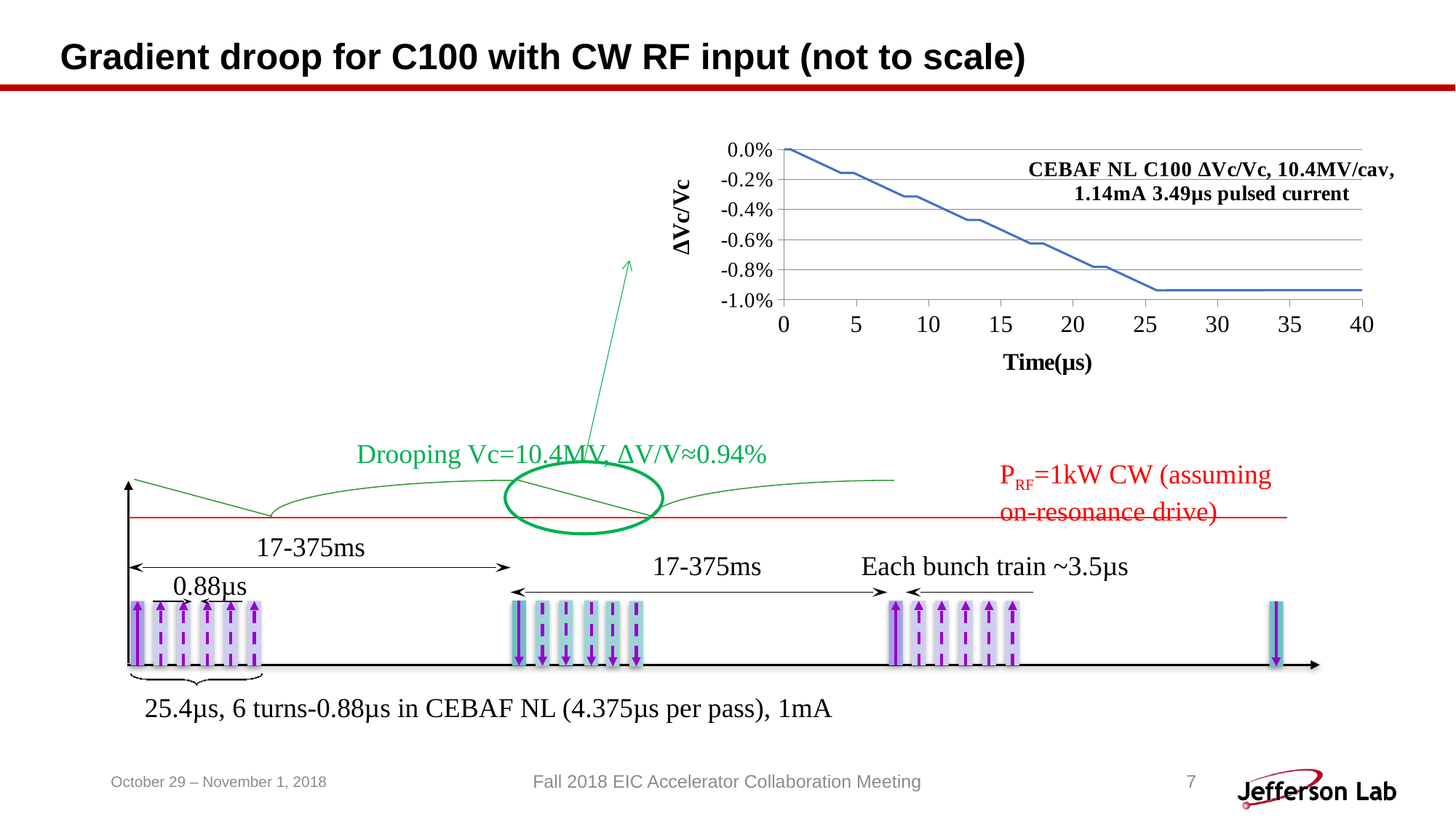
At what time does the chart show its highest value of ΔVc/Vc? 0 µs Is the value of ΔVc/Vc at 10 µs greater or less than -0.4%? greater What is the label of the x axis of the chart? Time(µs) Does ΔVc/Vc rise or fall as time increases from 0 to 25 µs? fall Which is larger, the value of ΔVc/Vc at 5 µs or at 25 µs? 5 µs What kind of chart is shown on the slide? line chart Is the value of ΔVc/Vc at 35 µs greater or less than -1.0%? greater What is the title of the chart? CEBAF NL C100 ΔVc/Vc, 10.4MV/cav, 1.14mA 3.49µs pulsed current What is the value of ΔVc/Vc at time 0 µs? 0.0% Is the value of ΔVc/Vc at 30 µs greater or less than -0.8%? less How many tick labels are shown on the x axis of the chart? 9